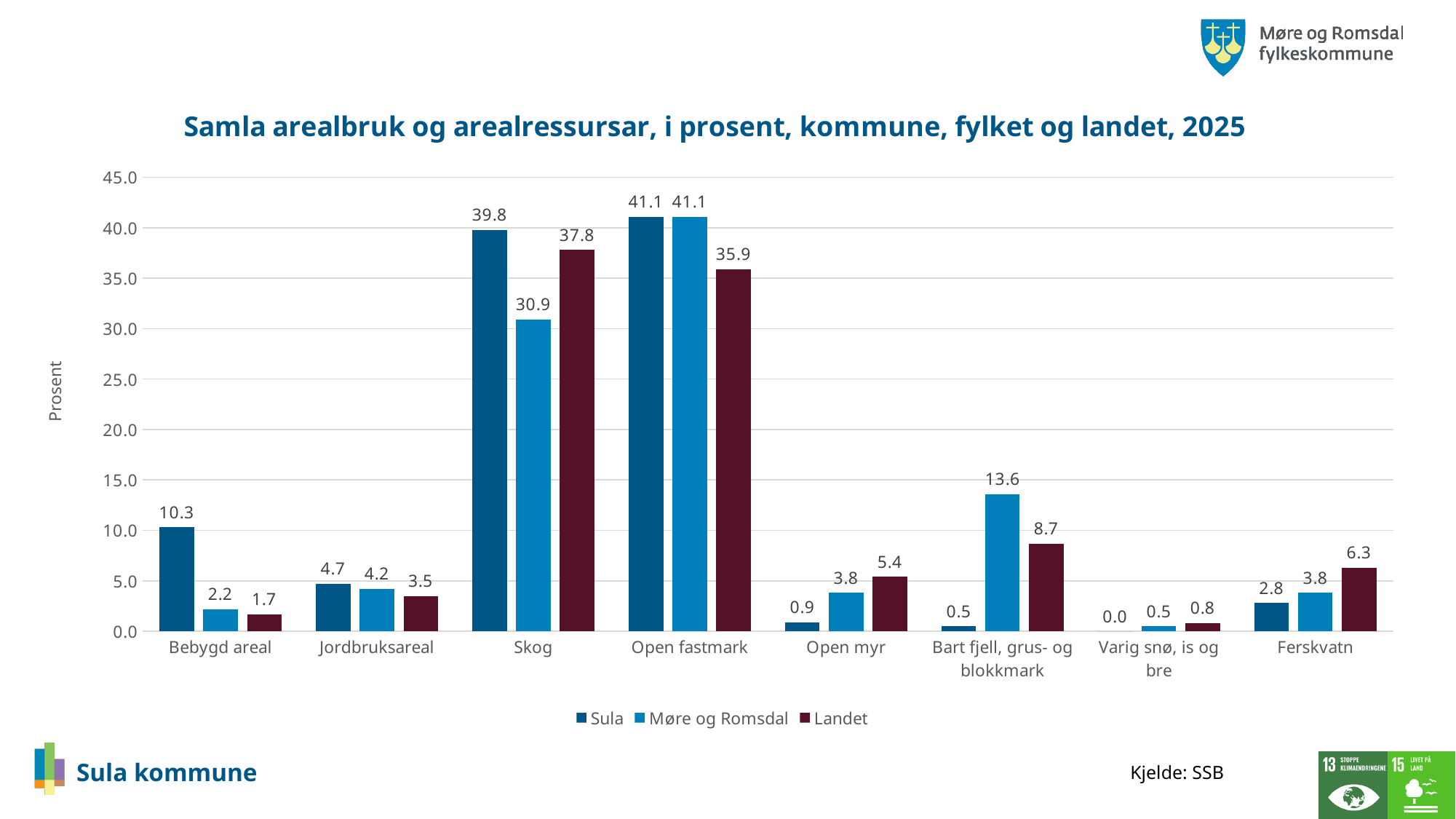
What is the value for Møre og Romsdal in the Bart fjell, grus- og blokkmark category? 13.6 What kind of chart is shown on the slide? Bar chart What is the label on the y axis? Prosent What is the value for Landet in the Open fastmark category? 35.9 Which is larger for Skog: the value for Møre og Romsdal or the value for Landet? Landet What is the title of the chart? Samla arealbruk og arealressursar, i prosent, kommune, fylket og landet, 2025 How many series does the legend list? 3 What is the value for Sula in the Skog category? 39.8 Which category has the highest value for Sula? Open fastmark Which category has the lowest value for Landet? Varig snø, is og bre How many categories are shown on the x axis? 8 What is the difference between the Sula and Landet values for Bebygd areal? 8.6